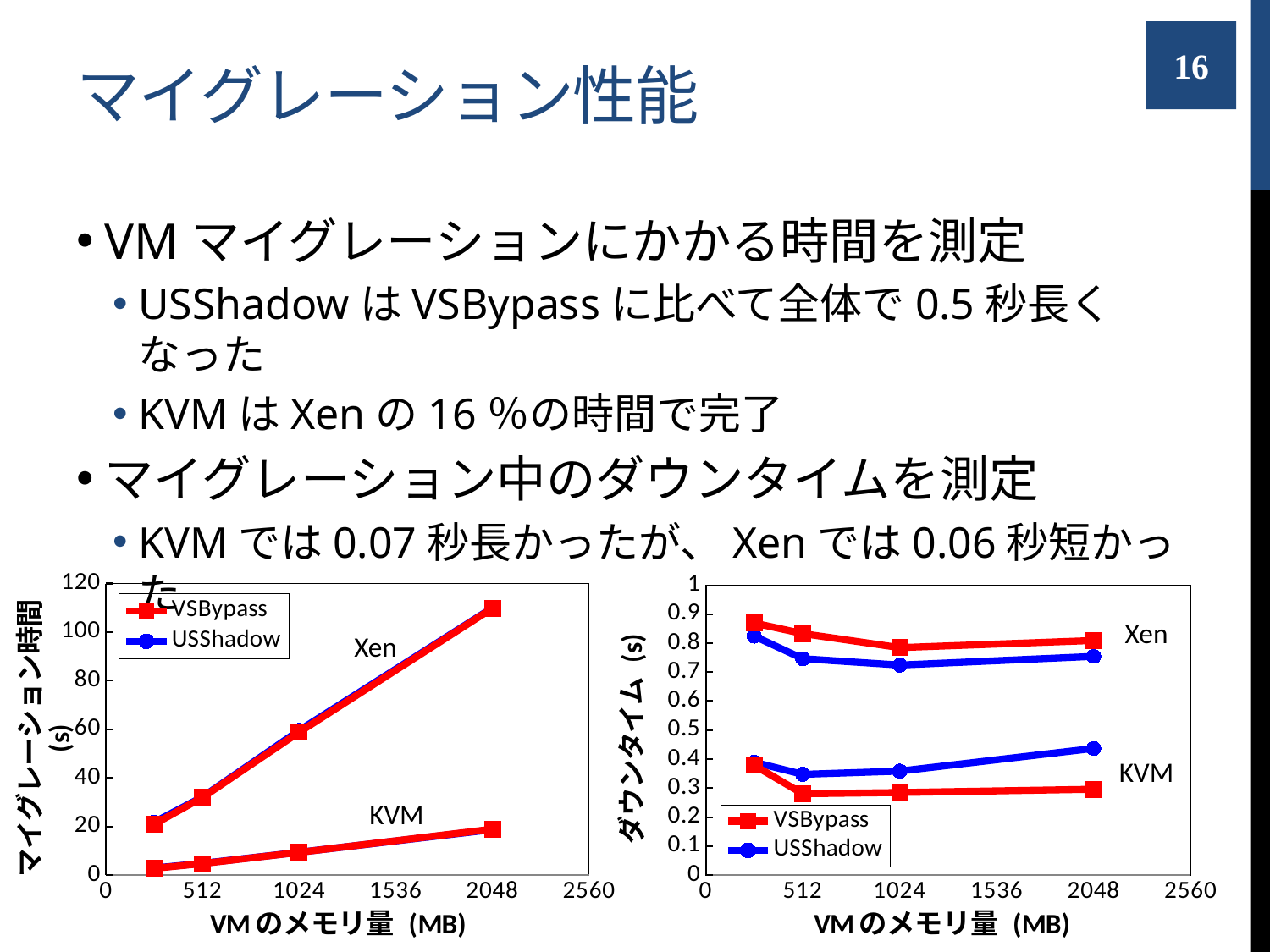
In the left chart (マイグレーション時間), does the Xen migration time rise or fall as VM memory increases? rise In the left chart (マイグレーション時間), is the Xen migration time at 2048 MB greater or less than 100? greater What kind of chart is the left chart (マイグレーション時間)? line chart In the right chart (ダウンタイム), at 2048 MB, which KVM series has the larger downtime, VSBypass or USShadow? USShadow In the right chart (ダウンタイム), is the KVM USShadow downtime at 2048 MB greater or less than 0.4? greater In the right chart (ダウンタイム), is the Xen VSBypass downtime at 256 MB greater or less than 0.8? greater How many data points are plotted for each series in the left chart (マイグレーション時間)? 4 What is the x-axis label of the right chart (ダウンタイム)? VM のメモリ量 (MB) How many series does the legend of the right chart (ダウンタイム) list? 2 In the left chart (マイグレーション時間), what are the two series named in the legend? VSBypass and USShadow